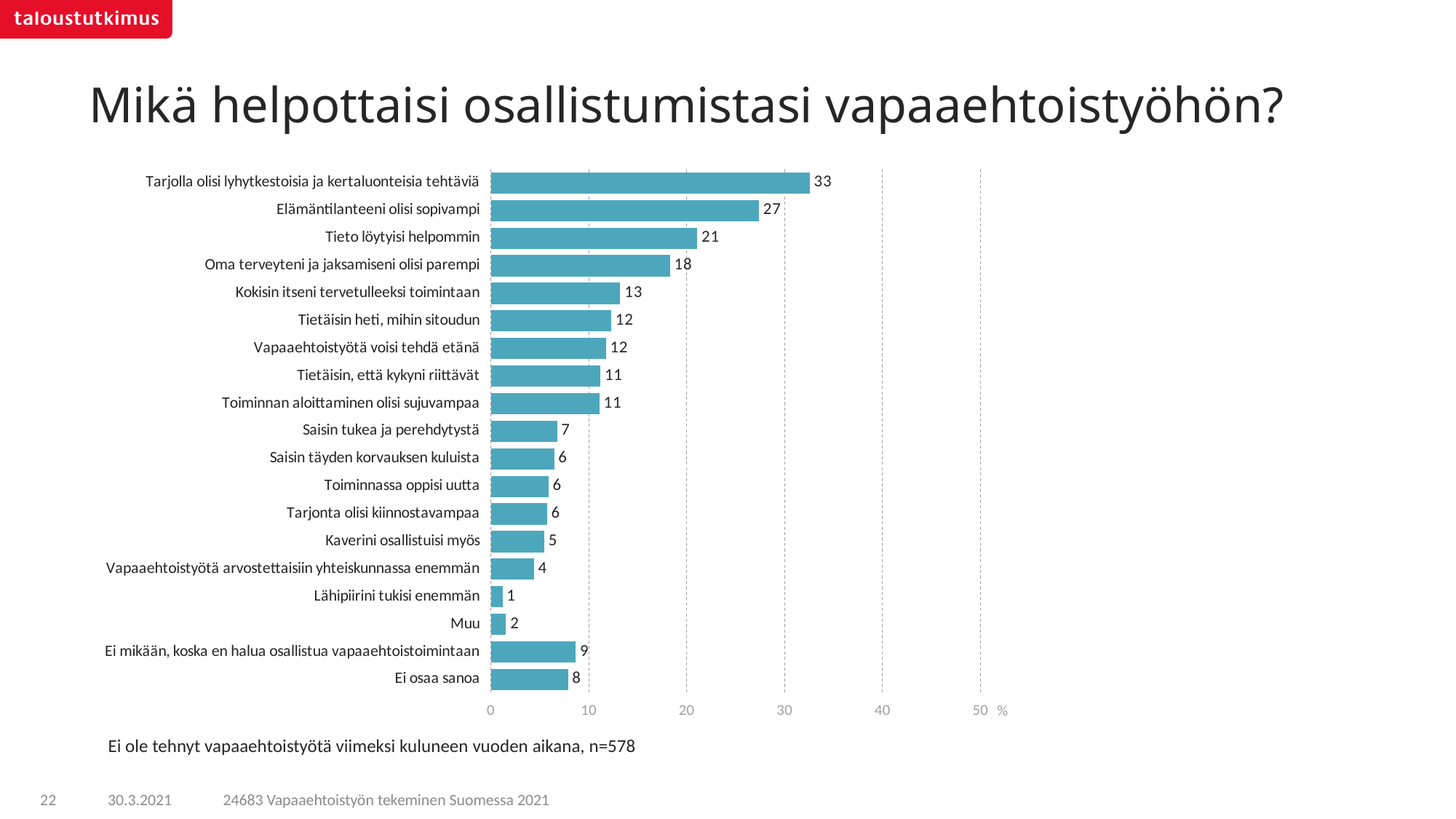
Which category has the lowest value? Lähipiirini tukisi enemmän Is the value for "Tieto löytyisi helpommin" greater or less than 20? greater Which category has the highest value? Tarjolla olisi lyhytkestoisia ja kertaluonteisia tehtäviä What is the value for "Elämäntilanteeni olisi sopivampi"? 27 How many categories are shown in the chart? 19 What is the sample size (n) stated below the chart? n=578 What is the title of the chart? Mikä helpottaisi osallistumistasi vapaaehtoistyöhön? What kind of chart is shown on the slide? bar chart What is the difference between the values for "Tarjolla olisi lyhytkestoisia ja kertaluonteisia tehtäviä" and "Tieto löytyisi helpommin"? 12 What is the value for "Ei mikään, koska en halua osallistua vapaaehtoistoimintaan"? 9 Which is larger: the value for "Oma terveyteni ja jaksamiseni olisi parempi" or the value for "Ei osaa sanoa"? Oma terveyteni ja jaksamiseni olisi parempi What is the value for "Kokisin itseni tervetulleeksi toimintaan"? 13